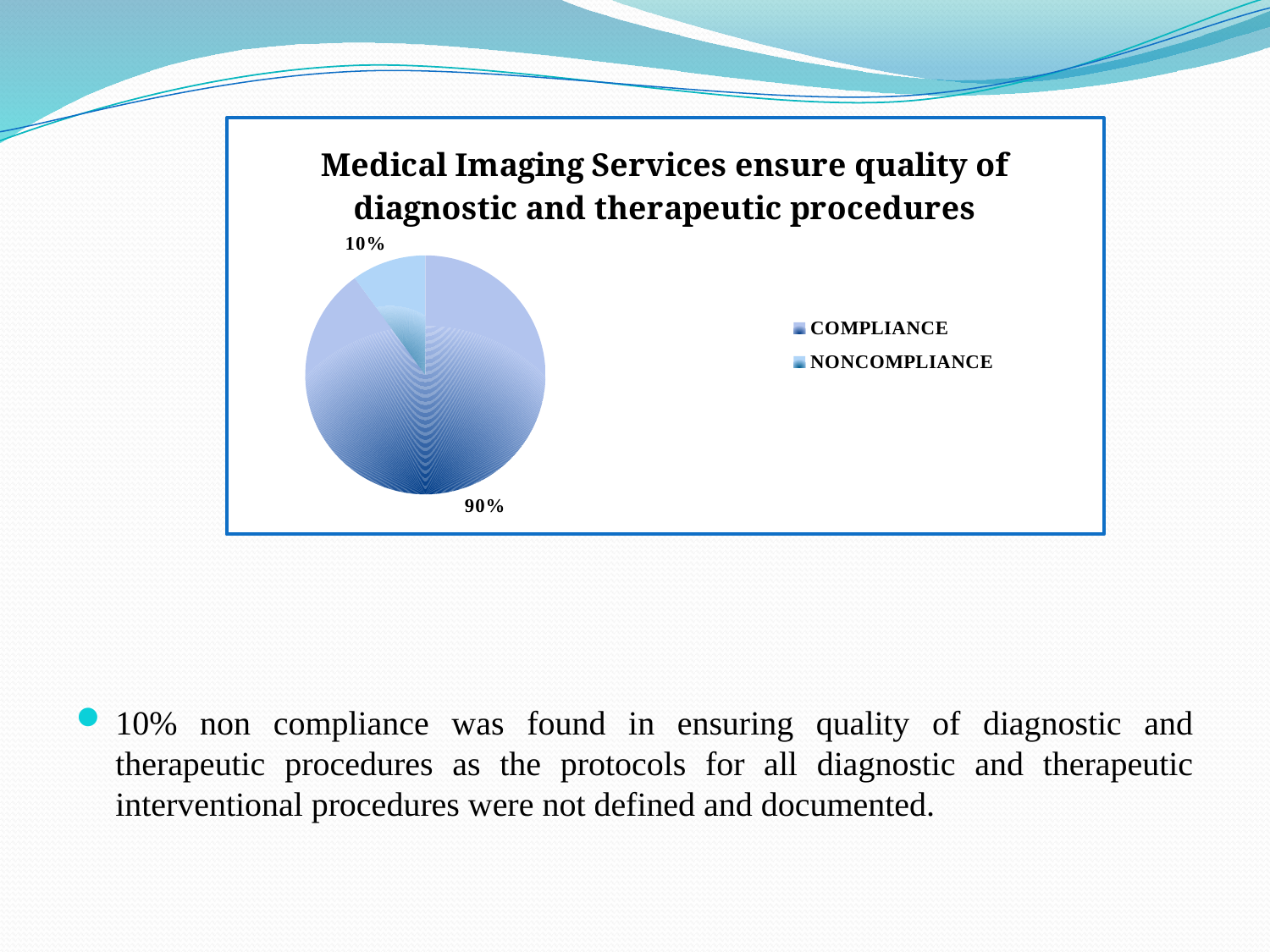
Which is larger, COMPLIANCE or NONCOMPLIANCE? COMPLIANCE What share of the pie does NONCOMPLIANCE represent? 10% How many slices does the pie chart have? 2 What is the value for COMPLIANCE? 90% What is the value for NONCOMPLIANCE? 10% How many entries does the legend list? 2 Which category has the smallest slice? NONCOMPLIANCE What is the title of the chart? Medical Imaging Services ensure quality of diagnostic and therapeutic procedures What type of chart is shown on the slide? pie chart Which category has the largest slice? COMPLIANCE Which legend entry is listed first? COMPLIANCE What is the difference between the COMPLIANCE and NONCOMPLIANCE values? 80%